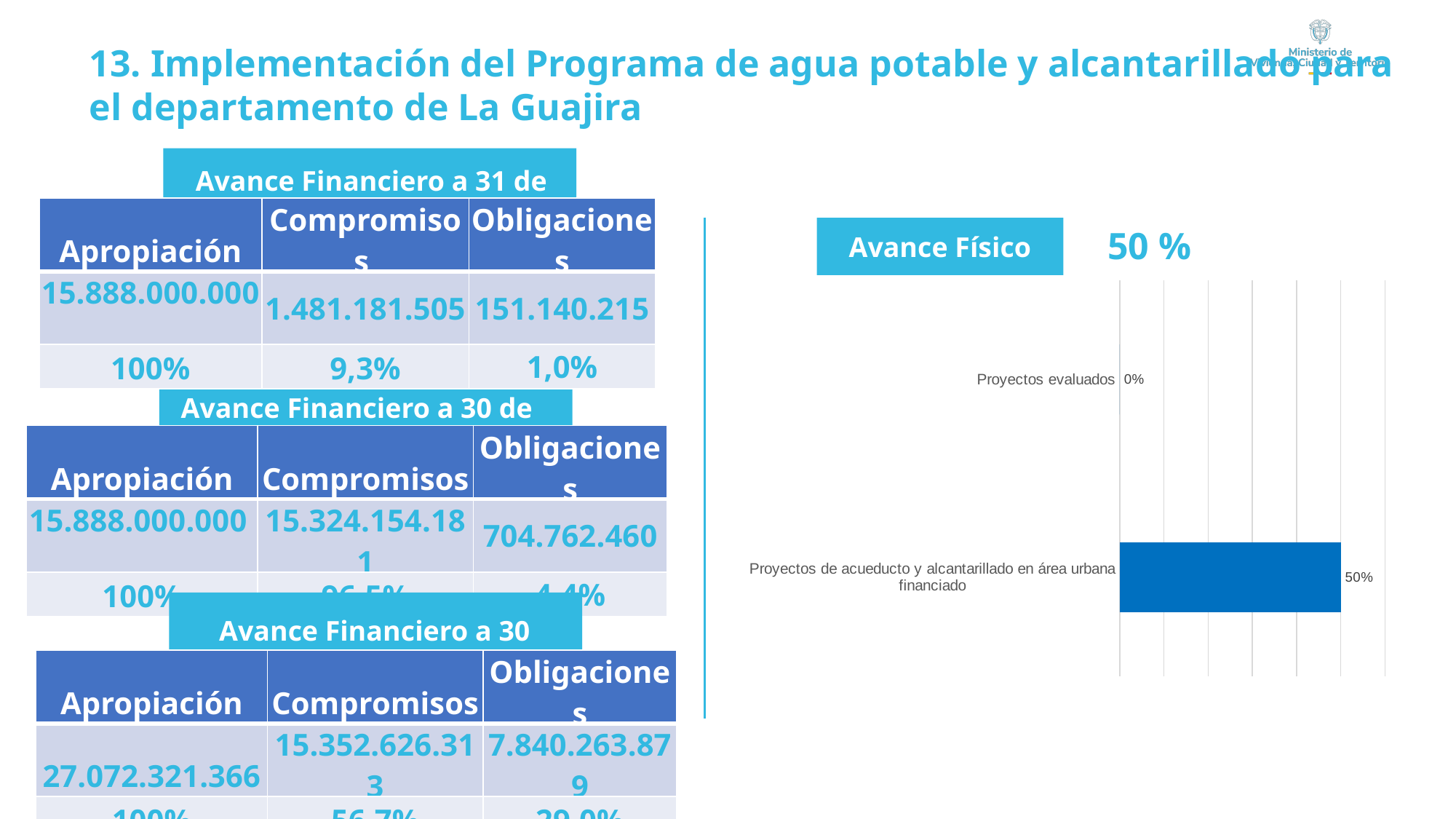
What is the value for "Proyectos de acueducto y alcantarillado en área urbana financiado" in the bar chart? 50% In the bar chart, which is larger: the value for "Proyectos evaluados" or the value for "Proyectos de acueducto y alcantarillado en área urbana financiado"? Proyectos de acueducto y alcantarillado en área urbana financiado Which category has the highest value in the bar chart? Proyectos de acueducto y alcantarillado en área urbana financiado How many categories does the bar chart show? 2 Are the bars in the chart horizontal or vertical? horizontal What label appears in the box above the bar chart? Avance Físico What is the difference between the values for "Proyectos de acueducto y alcantarillado en área urbana financiado" and "Proyectos evaluados" in the bar chart? 50% Which category has the lowest value in the bar chart? Proyectos evaluados What is the value for "Proyectos evaluados" in the bar chart? 0% What kind of chart is shown on the right side of the slide? bar chart